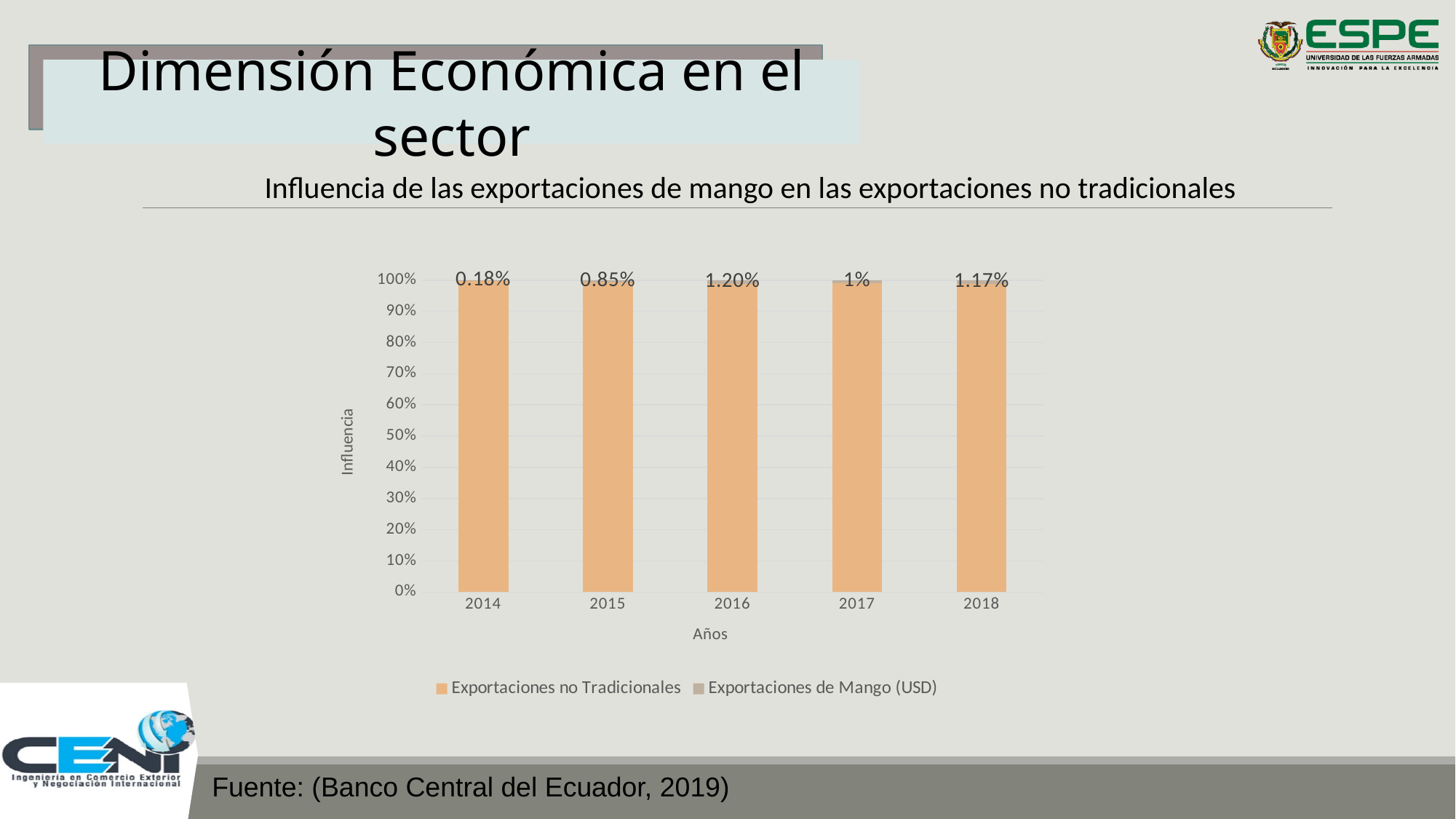
What is the data label shown for Exportaciones de Mango (USD) in 2018? 1.17% In which year is the labelled share of Exportaciones de Mango (USD) the highest? 2016 What is the data label shown for Exportaciones de Mango (USD) in 2016? 1.20% How many years are shown on the x axis of the chart? 5 What is the difference between the labelled mango export share in 2016 and in 2014? 1.02% In which year is the labelled share of Exportaciones de Mango (USD) the lowest? 2014 What is the data label shown for Exportaciones de Mango (USD) in 2017? 1% How many series does the chart legend list? 2 What kind of chart is shown on the slide? Stacked bar chart What is the data label shown for Exportaciones de Mango (USD) in 2014? 0.18% Which year has a larger labelled mango export share, 2015 or 2018? 2018 Does the labelled mango export share rise or fall from 2014 to 2016? Rise